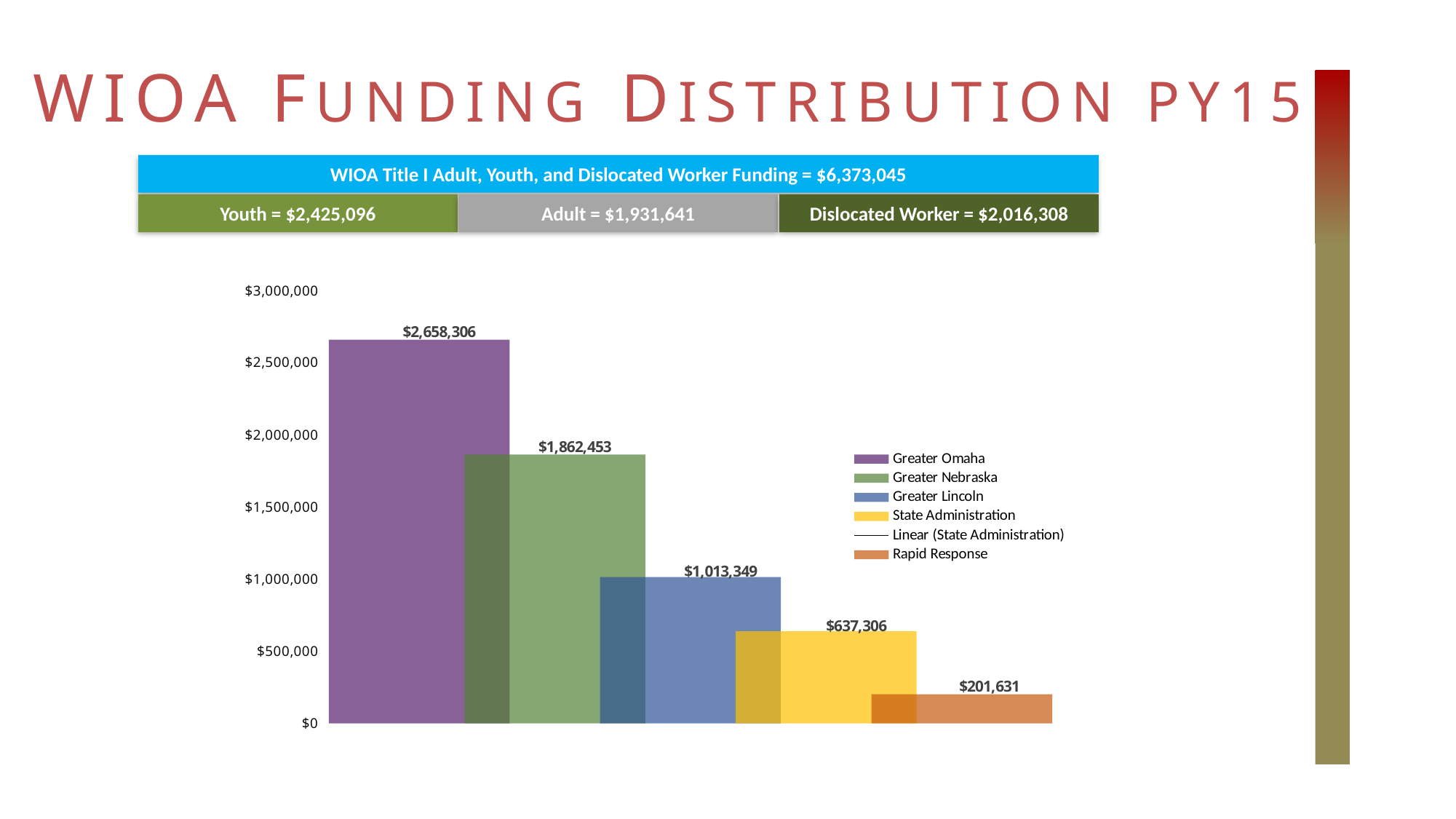
Is the value for State Administration greater or less than $500,000? greater What is the value for Greater Lincoln? $1,013,349 How many bars are plotted in the chart? 5 What kind of chart is shown on the slide? bar chart What is the difference between the values for Greater Omaha and Greater Nebraska? $795,853 What is the value for Rapid Response? $201,631 Which is larger, the value for Greater Nebraska or the value for Greater Lincoln? Greater Nebraska What is the value for Greater Omaha? $2,658,306 How many entries does the legend list? 6 Which category has the highest value? Greater Omaha Which category has the lowest value? Rapid Response What is the difference between the values for State Administration and Rapid Response? $435,675